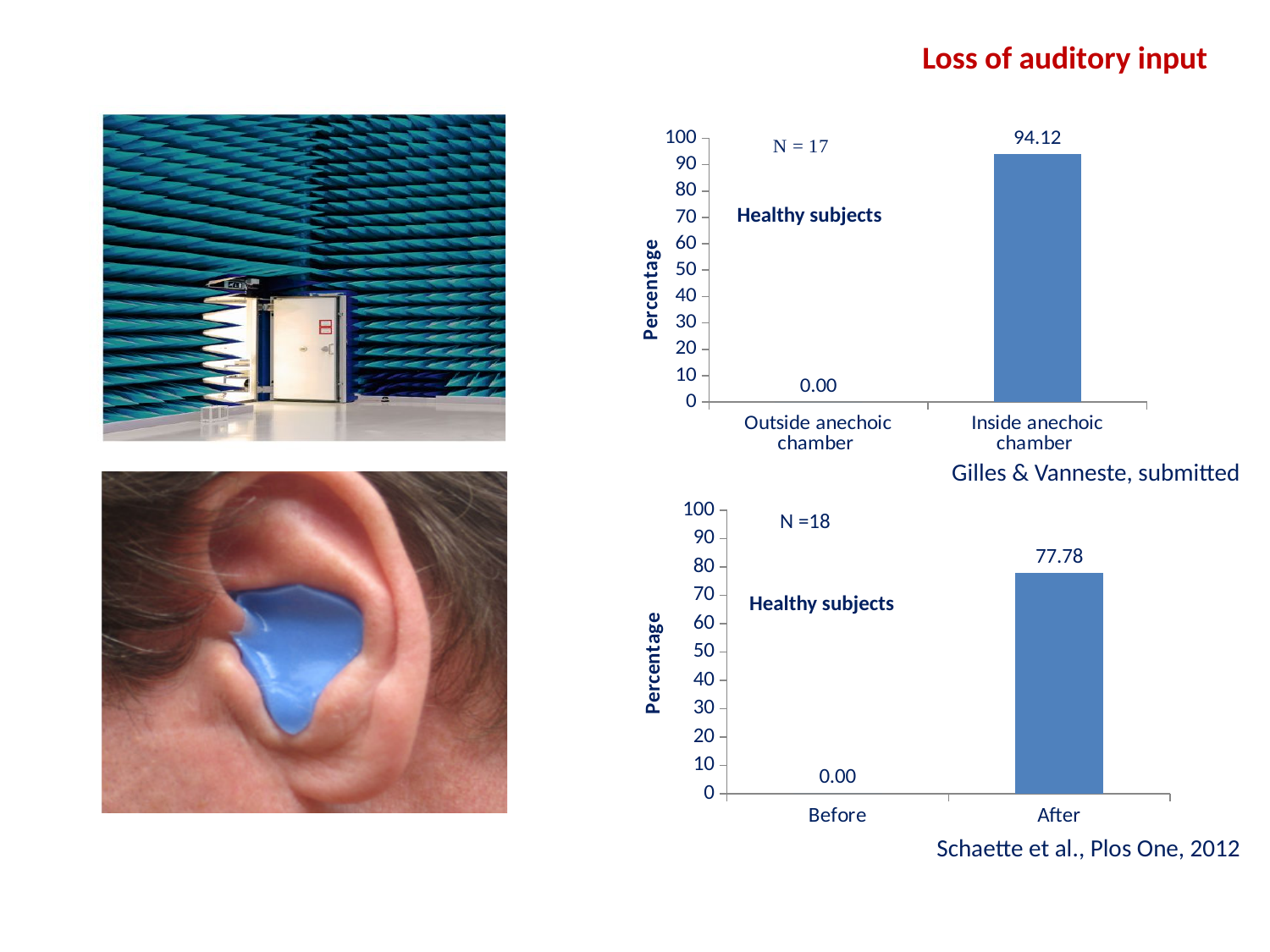
In the top chart (Outside/Inside anechoic chamber), what is the label of the y axis? Percentage In the top chart (Outside/Inside anechoic chamber), how many categories are shown on the x axis? 2 In the bottom chart (Before/After), which category has the lowest value? Before In the top chart (Outside/Inside anechoic chamber), what is the difference between the Inside and Outside anechoic chamber values? 94.12 In the bottom chart (Before/After), what sample size (N) is stated on the chart? N =18 What kind of chart is the bottom chart (Before/After)? bar chart In the bottom chart (Before/After), what is the value for Before? 0.00 In the top chart (Outside/Inside anechoic chamber), which category has the highest value? Inside anechoic chamber In the bottom chart (Before/After), what is the value for After? 77.78 In the bottom chart (Before/After), is the value for After greater or less than 70? greater In the top chart (Outside/Inside anechoic chamber), what is the value for Outside anechoic chamber? 0.00 In the top chart (Outside/Inside anechoic chamber), what is the value for Inside anechoic chamber? 94.12